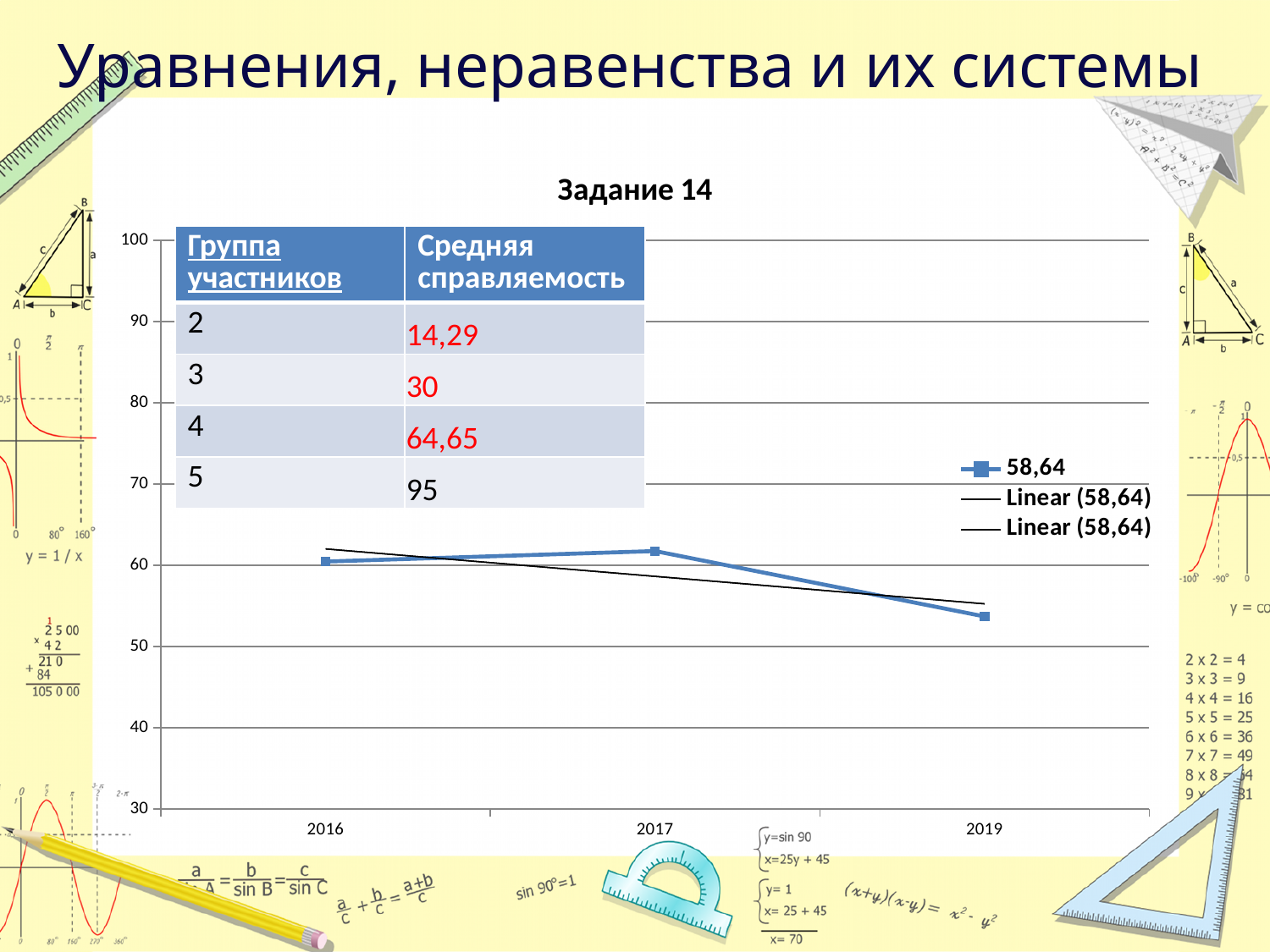
How many entries does the legend of the "Задание 14" chart list? 3 What is the title of the chart on the slide? Задание 14 In the "Задание 14" chart, is the value for 2017 greater or less than 60? greater In the "Задание 14" chart, which year has the highest value? 2017 In the "Задание 14" chart, is the value for 2016 greater or less than 70? less In the "Задание 14" chart, which is larger, the value for 2017 or the value for 2019? 2017 In the "Задание 14" chart, does the value rise or fall from 2017 to 2019? fall What is the name of the plotted data series shown in the legend of the "Задание 14" chart? 58,64 In the "Задание 14" chart, which year has the lowest value? 2019 In the "Задание 14" chart, is the value for 2019 greater or less than 60? less What kind of chart is shown under the title "Задание 14"? line chart How many data points are plotted on the line in the "Задание 14" chart? 3